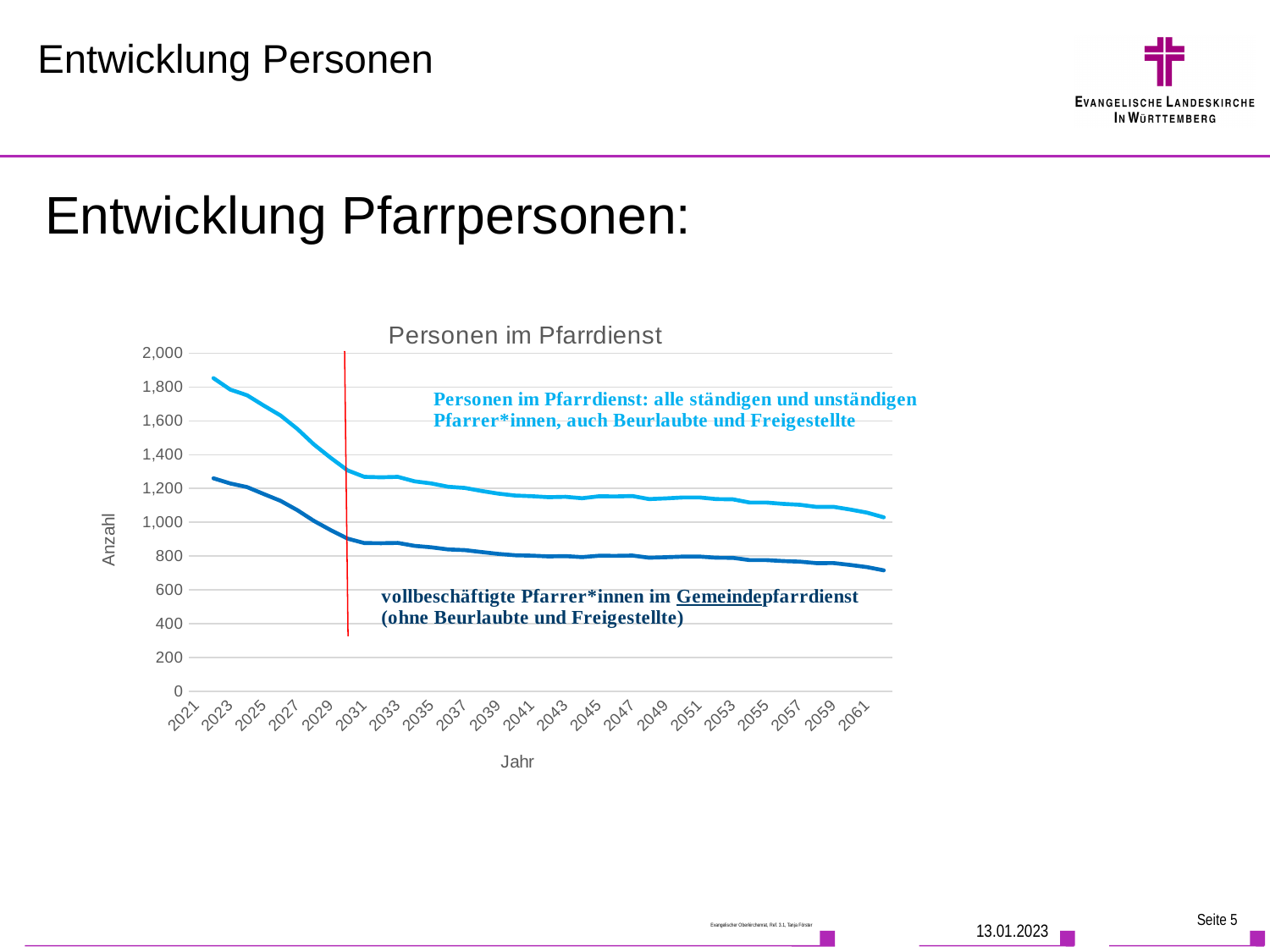
What is the label of the vertical axis of the chart? Anzahl Is the value of the dark blue line (vollbeschäftigte Pfarrer*innen im Gemeindepfarrdienst) in 2061 greater or less than 800? less In 2021, which line has the higher value: the light blue line (Personen im Pfarrdienst) or the dark blue line (vollbeschäftigte Pfarrer*innen im Gemeindepfarrdienst)? the light blue line (Personen im Pfarrdienst) Do the values of the dark blue line (vollbeschäftigte Pfarrer*innen im Gemeindepfarrdienst) rise or fall from 2021 to 2061? fall What is the title of the chart? Personen im Pfarrdienst What kind of chart is shown on the slide? line chart In which year does the light blue line (Personen im Pfarrdienst) reach its highest value? 2022 Do the values of the light blue line (Personen im Pfarrdienst) rise or fall from 2021 to 2061? fall Is the value of the light blue line (Personen im Pfarrdienst) in 2021 greater or less than 1,600? greater How many year labels are shown on the x axis of the chart? 21 How many lines (series) are plotted in the chart? 2